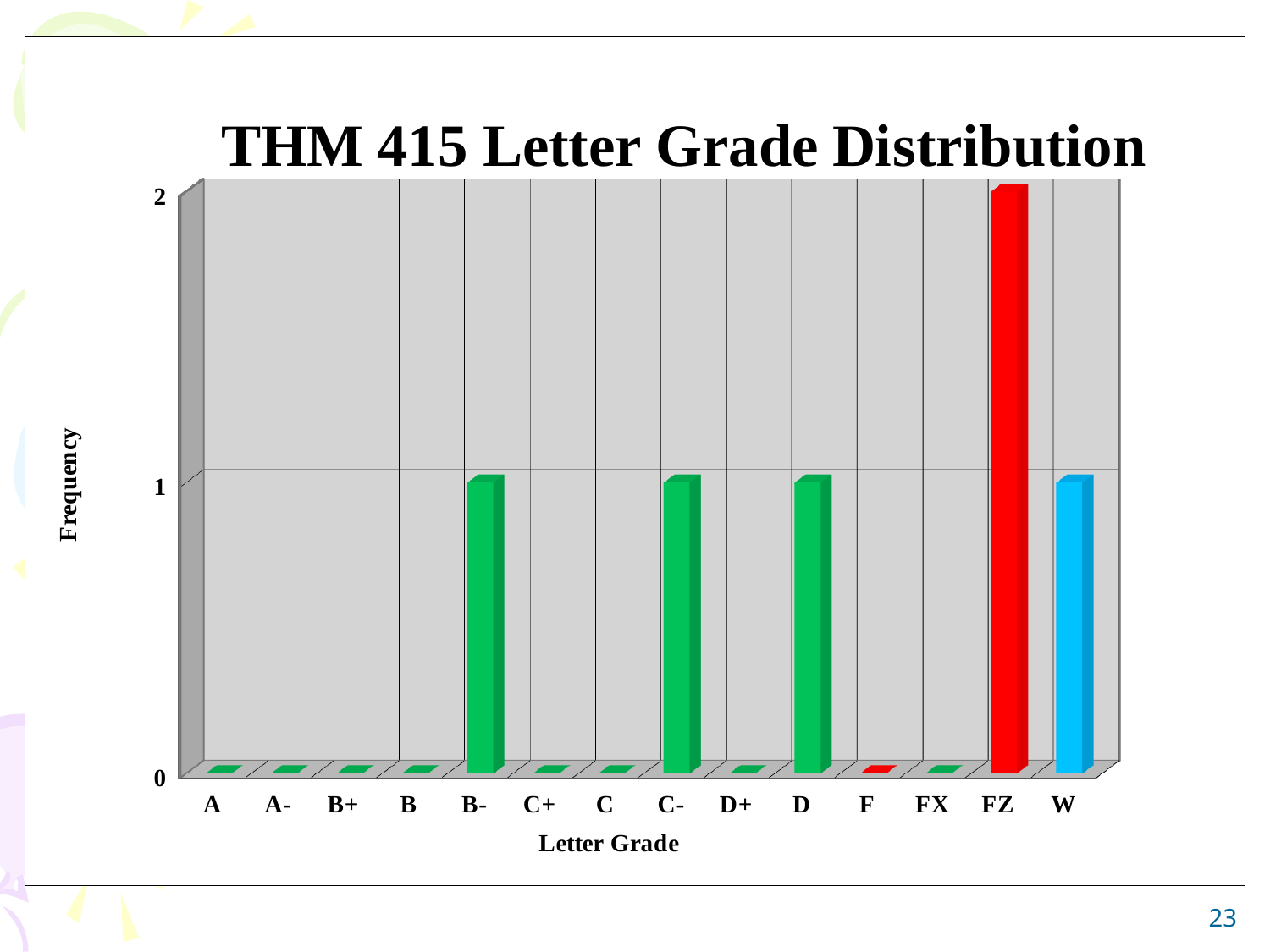
What is the frequency for the B- grade? 1 What is the label of the y axis? Frequency What is the title of the chart? THM 415 Letter Grade Distribution Which letter grade has the highest frequency? FZ What is the frequency for the W grade? 1 Which has a higher frequency, C- or C+? C- What is the difference in frequency between FZ and D? 1 What kind of chart is shown on the slide? bar chart What is the frequency for the A grade? 0 How many letter grade categories are shown on the x axis? 14 What is the frequency for the FZ grade? 2 What is the frequency for the F grade? 0